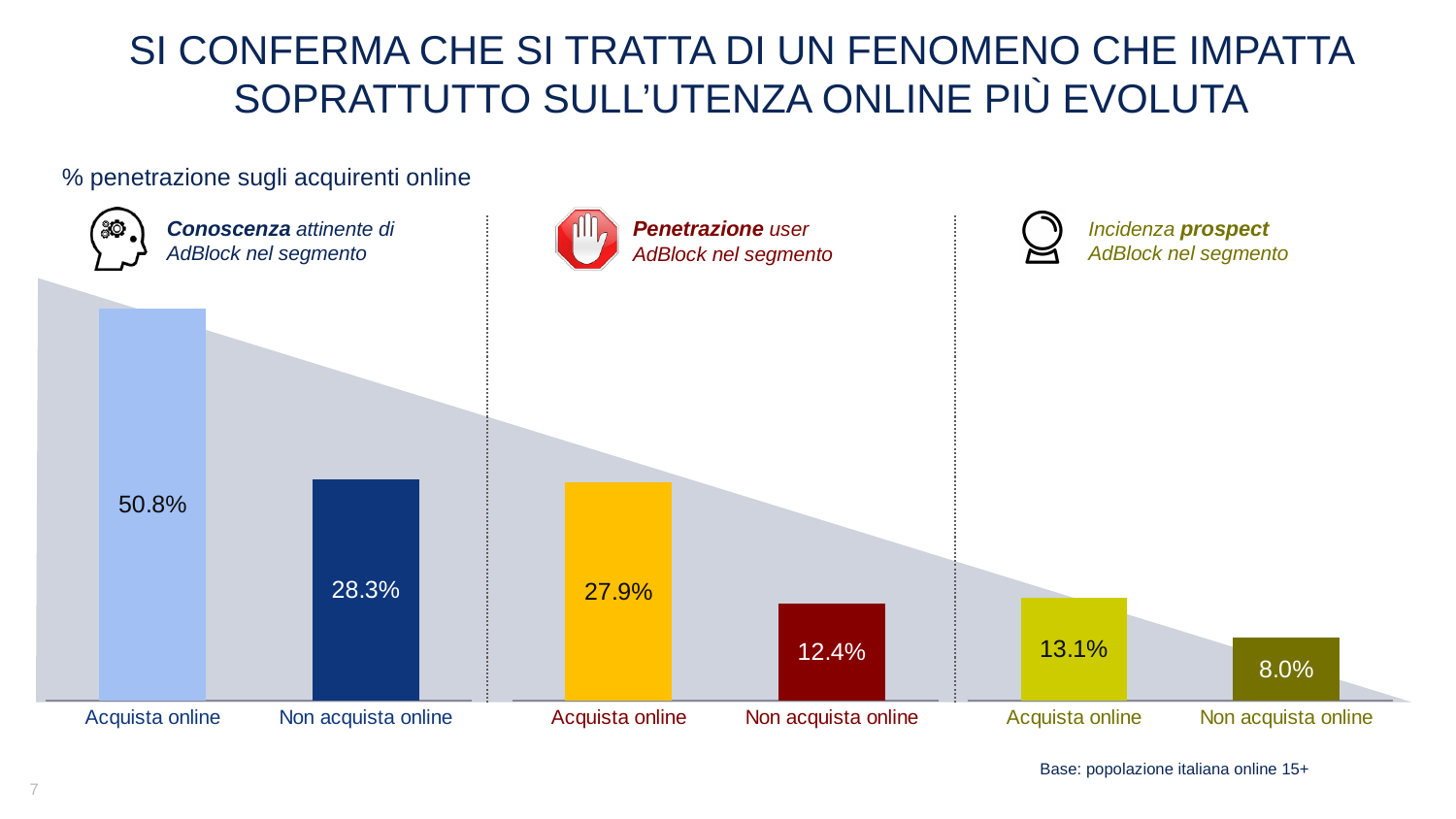
In the left chart (Conoscenza attinente di AdBlock nel segmento), what is the difference between Acquista online and Non acquista online? 22.5% In the right chart (Incidenza prospect AdBlock nel segmento), what is the value for Acquista online? 13.1% In the left chart (Conoscenza attinente di AdBlock nel segmento), what is the value for Non acquista online? 28.3% In the right chart (Incidenza prospect AdBlock nel segmento), what is the value for Non acquista online? 8.0% In the middle chart (Penetrazione user AdBlock nel segmento), what is the value for Non acquista online? 12.4% What type of chart is used in the left chart (Conoscenza attinente di AdBlock nel segmento)? Bar chart In the middle chart (Penetrazione user AdBlock nel segmento), what is the value for Acquista online? 27.9% In the middle chart (Penetrazione user AdBlock nel segmento), what is the difference between Acquista online and Non acquista online? 15.5% In the right chart (Incidenza prospect AdBlock nel segmento), what is the difference between Acquista online and Non acquista online? 5.1% In the right chart (Incidenza prospect AdBlock nel segmento), which category has the higher value, Acquista online or Non acquista online? Acquista online How many bars are shown in the middle chart (Penetrazione user AdBlock nel segmento)? 2 In the left chart (Conoscenza attinente di AdBlock nel segmento), what is the value for Acquista online? 50.8%